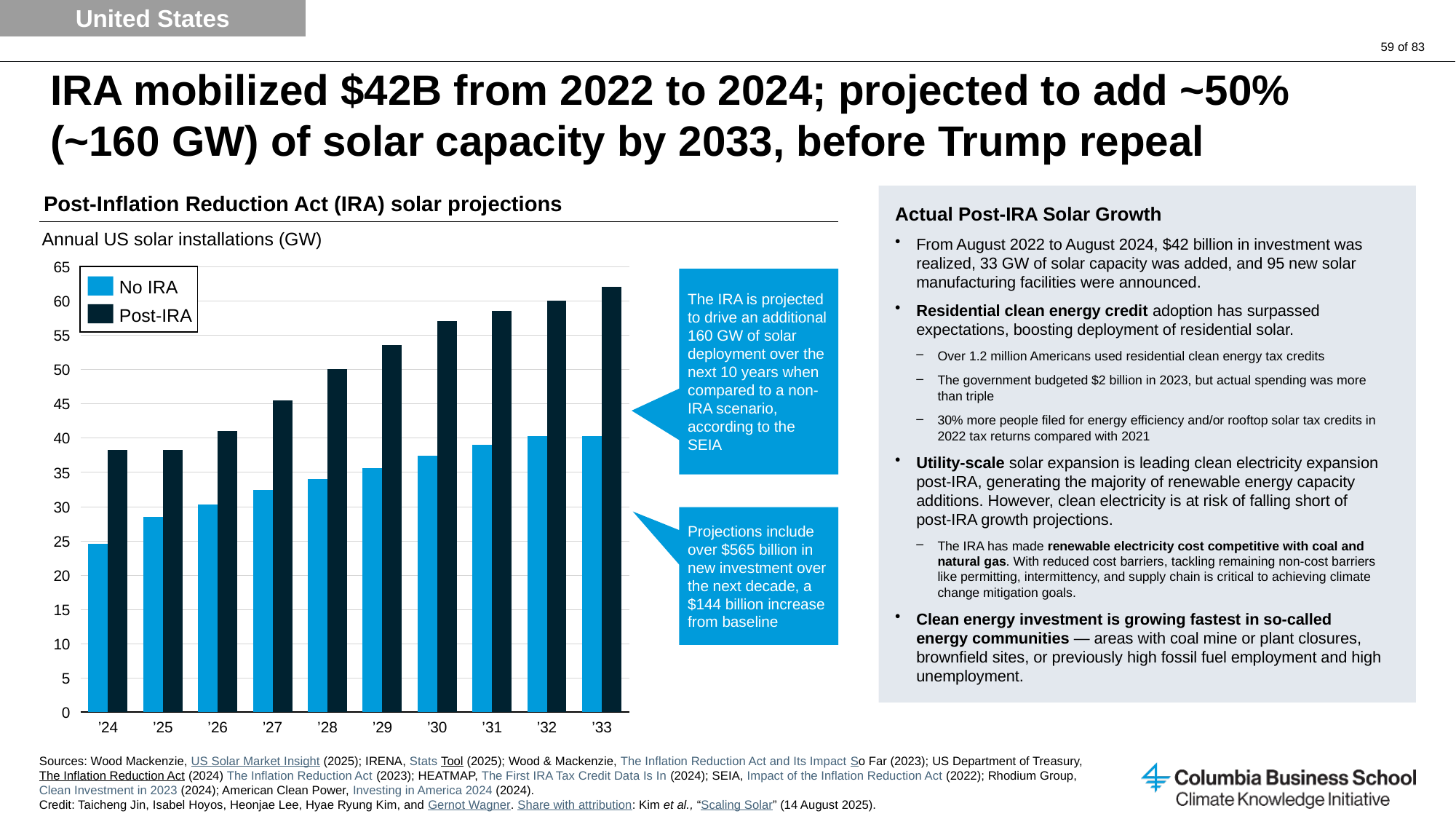
In '30, which is larger, the No IRA value or the Post-IRA value? Post-IRA What quantity does the chart's y axis measure, according to the subtitle? Annual US solar installations (GW) Do the Post-IRA values generally rise or fall from '24 to '33? rise Which year has the lowest No IRA value? '24 What kind of chart is shown on the slide? bar chart How many series does the chart legend list? 2 How many years are shown on the x axis of the chart? 10 Which legend entry is shown in dark navy? Post-IRA Is the Post-IRA value for '33 greater or less than 60? greater Which year has the highest Post-IRA value? '33